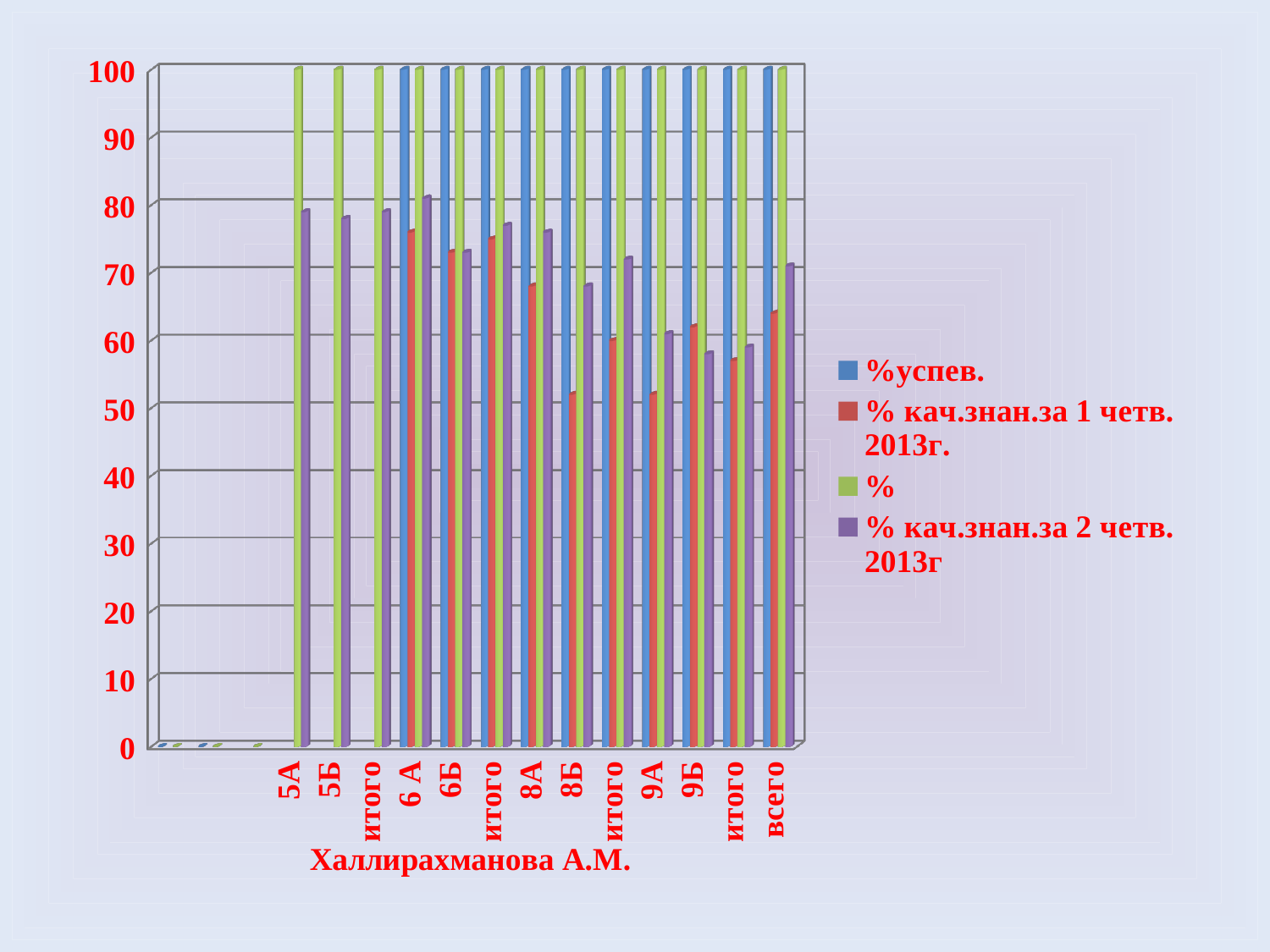
What is the value of the green "%" series for 5А? 100 How many categories are shown along the x axis? 13 What is the value of the "%успев." series for всего? 100 Is the value of "% кач.знан.за 1 четв. 2013г." for 8Б greater or less than 60? less Is the value of "% кач.знан.за 2 четв. 2013г" for 5А greater or less than 70? greater For 8Б, which is larger: "% кач.знан.за 1 четв. 2013г." or "% кач.знан.за 2 четв. 2013г"? % кач.знан.за 2 четв. 2013г What text appears below the category labels on the x axis? Халлирахманова А.М. What kind of chart is shown on the slide? bar chart Is the value of "% кач.знан.за 2 четв. 2013г" for 9Б greater or less than 50? greater Which is larger: the "% кач.знан.за 2 четв. 2013г" value for 8А or for 8Б? 8А How many series does the legend list? 4